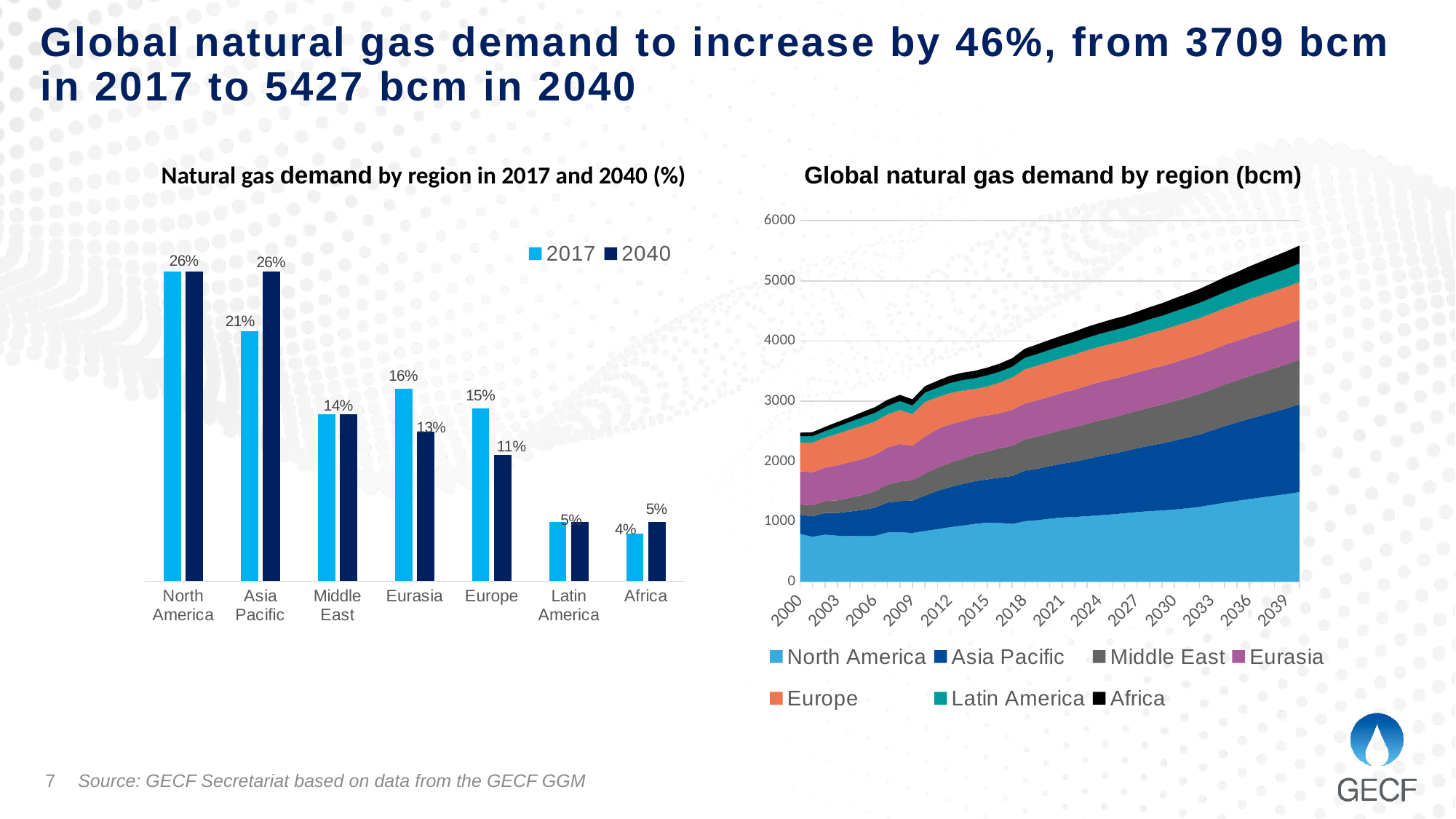
In the chart 'Natural gas demand by region in 2017 and 2040 (%)', what is the difference between the 2017 and 2040 values for Asia Pacific? 5% How many regions are shown on the x axis of the chart 'Natural gas demand by region in 2017 and 2040 (%)'? 7 In the chart 'Natural gas demand by region in 2017 and 2040 (%)', what is the 2017 value for Asia Pacific? 21% In the chart 'Natural gas demand by region in 2017 and 2040 (%)', which region has the lowest 2017 value? Africa What kind of chart is 'Global natural gas demand by region (bcm)'? Stacked area chart In the chart 'Global natural gas demand by region (bcm)', does total demand rise or fall from 2000 to 2039? rise In the chart 'Natural gas demand by region in 2017 and 2040 (%)', what is the 2040 value for Europe? 11% How many series does the legend of the chart 'Natural gas demand by region in 2017 and 2040 (%)' list? 2 In the chart 'Global natural gas demand by region (bcm)', is the total demand in 2039 greater or less than 5000? greater How many regions does the legend of the chart 'Global natural gas demand by region (bcm)' list? 7 In the chart 'Natural gas demand by region in 2017 and 2040 (%)', is the 2017 value for Eurasia larger or smaller than the 2040 value for Eurasia? larger In the chart 'Natural gas demand by region in 2017 and 2040 (%)', what is the 2017 value for Africa? 4%